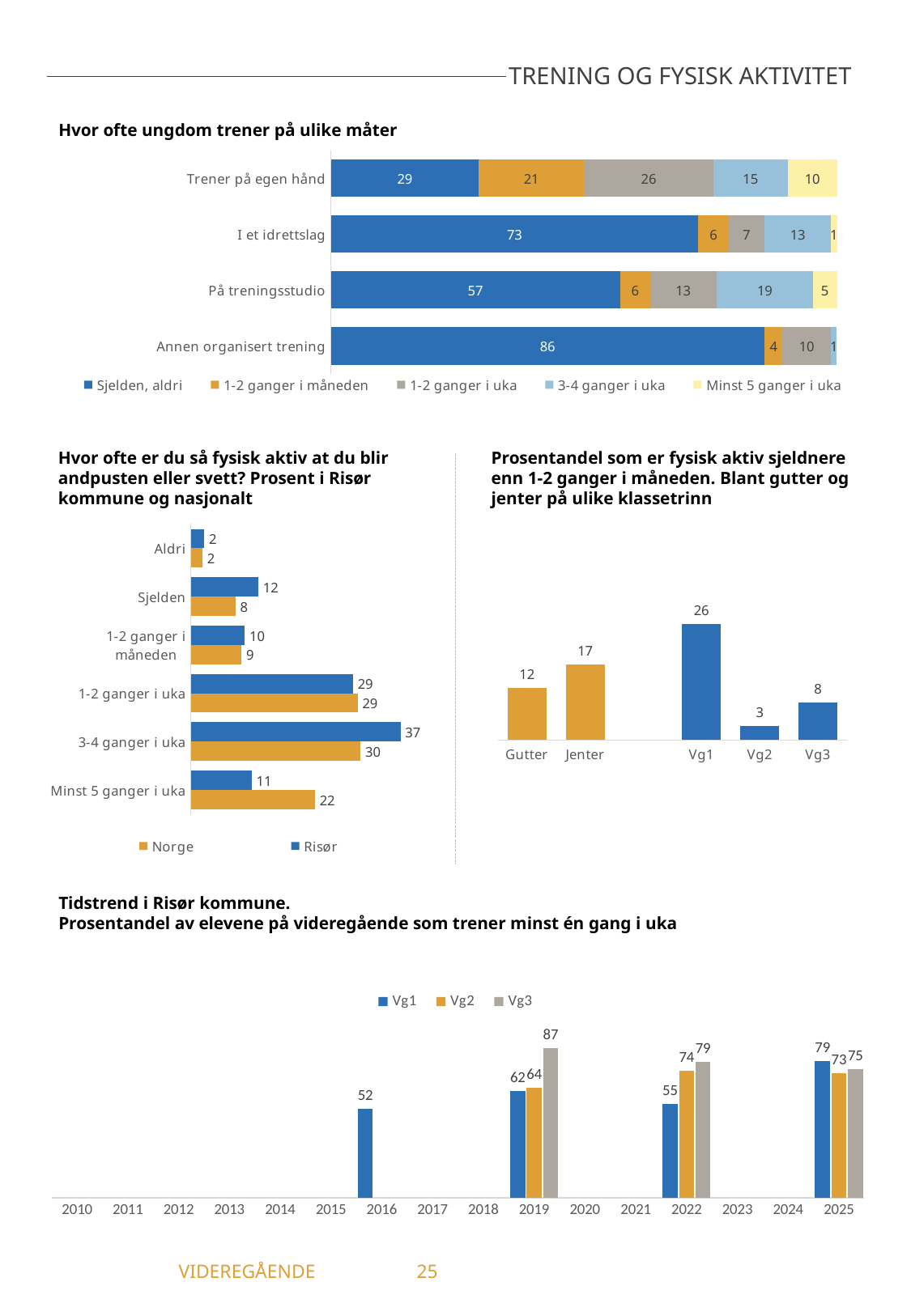
In the chart 'Prosentandel som er fysisk aktiv sjeldnere enn 1-2 ganger i måneden', what is the value for Jenter? 17 In the chart 'Hvor ofte er du så fysisk aktiv at du blir andpusten eller svett?', what is the value for Norge for 'Minst 5 ganger i uka'? 22 In the chart 'Hvor ofte ungdom trener på ulike måter', what is the total of the stacked bar for 'Trener på egen hånd'? 101 In the chart 'Hvor ofte ungdom trener på ulike måter', what is the value for 'Sjelden, aldri' for 'I et idrettslag'? 73 In the chart 'Hvor ofte er du så fysisk aktiv at du blir andpusten eller svett?', which is larger for 'Sjelden': Norge or Risør? Risør In the chart 'Hvor ofte ungdom trener på ulike måter', which category has the highest 'Sjelden, aldri' value? Annen organisert trening In the chart 'Tidstrend i Risør kommune', what kind of chart is it? Bar chart In the chart 'Prosentandel som er fysisk aktiv sjeldnere enn 1-2 ganger i måneden', which category has the lowest value? Vg2 In the chart 'Hvor ofte er du så fysisk aktiv at du blir andpusten eller svett?', what is the difference between Risør and Norge for '3-4 ganger i uka'? 7 In the chart 'Prosentandel som er fysisk aktiv sjeldnere enn 1-2 ganger i måneden', how many categories are shown? 5 In the chart 'Tidstrend i Risør kommune', what is the value for Vg3 in 2019? 87 In the chart 'Hvor ofte ungdom trener på ulike måter', how many series does the legend list? 5